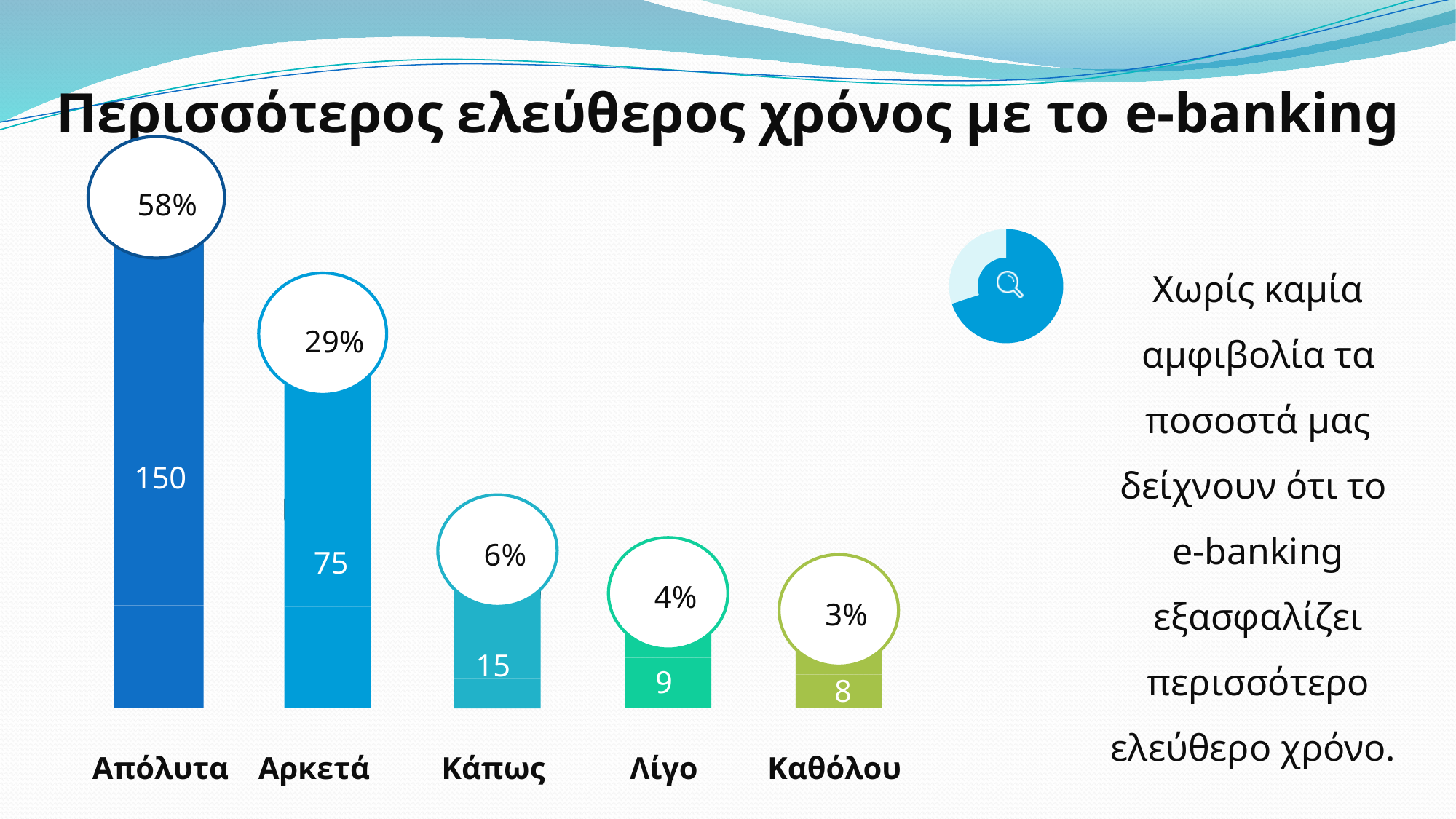
What percentage is shown above the bar for Καθόλου? 3% What kind of chart is shown on the slide? Bar chart What is the value shown on the bar for Απόλυτα? 150 Do the values rise or fall from left to right across the categories? Fall Which category has the lowest value? Καθόλου What is the value shown on the bar for Κάπως? 15 How many categories are shown in the chart? 5 What percentage is shown above the bar for Αρκετά? 29% What is the difference between the values for Λίγο and Καθόλου? 1 Which category has the highest value? Απόλυτα What is the difference between the values for Απόλυτα and Αρκετά? 75 Which is larger, the value for Κάπως or the value for Λίγο? Κάπως